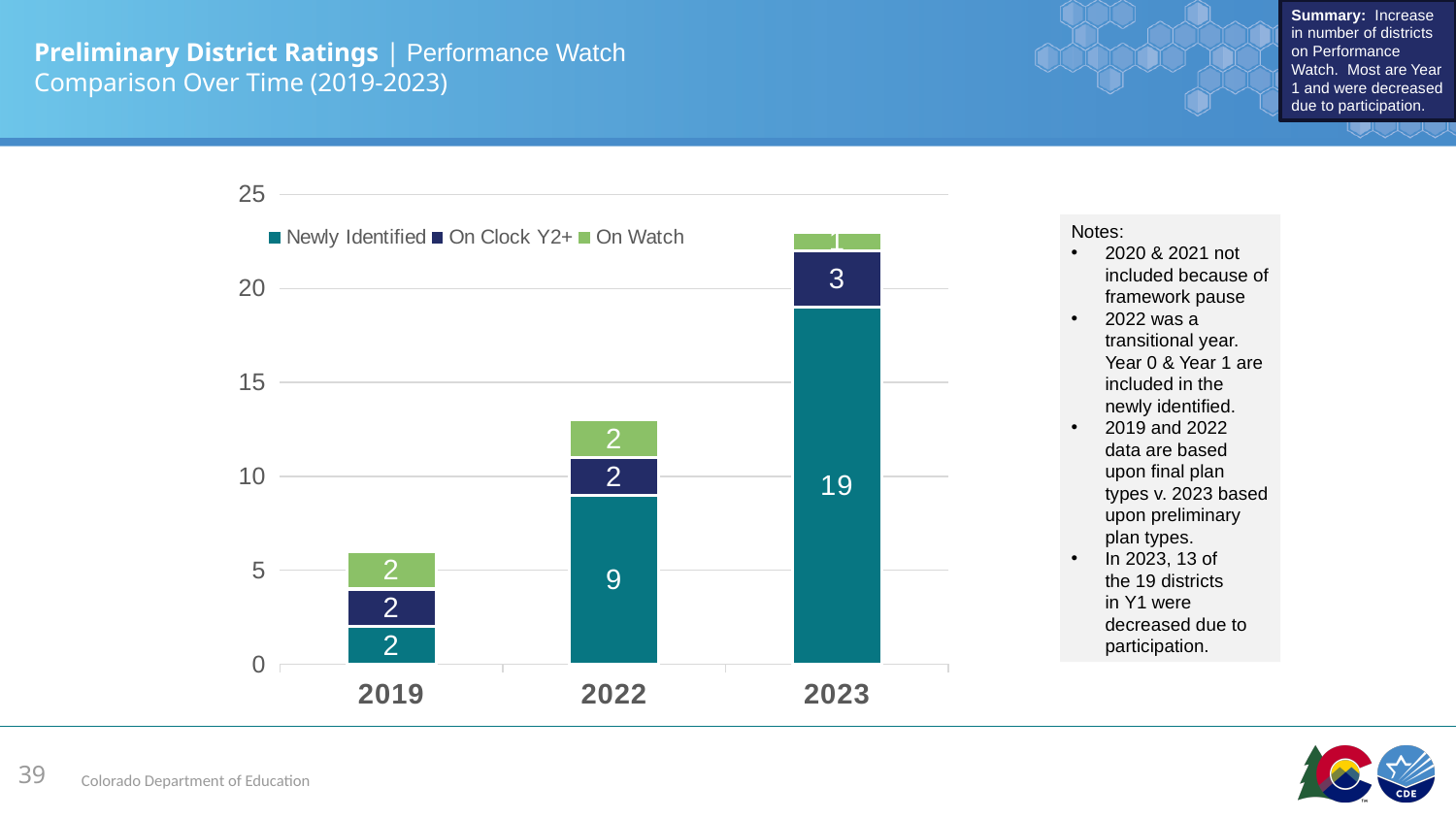
What is the Newly Identified value for 2022? 9 What is the difference between the Newly Identified values for 2023 and 2022? 10 What is the total of the stacked bar for 2019? 6 Which year has the tallest stacked bar? 2023 What is the Newly Identified value for 2023? 19 What is the total of the stacked bar for 2022? 13 Is the total height of the 2023 bar greater or less than 20? greater How many series does the chart legend list? 3 How many years are shown on the x axis of the chart? 3 What kind of chart is shown on the slide? Stacked bar chart What is the On Clock Y2+ value for 2023? 3 What is the On Watch value for 2019? 2